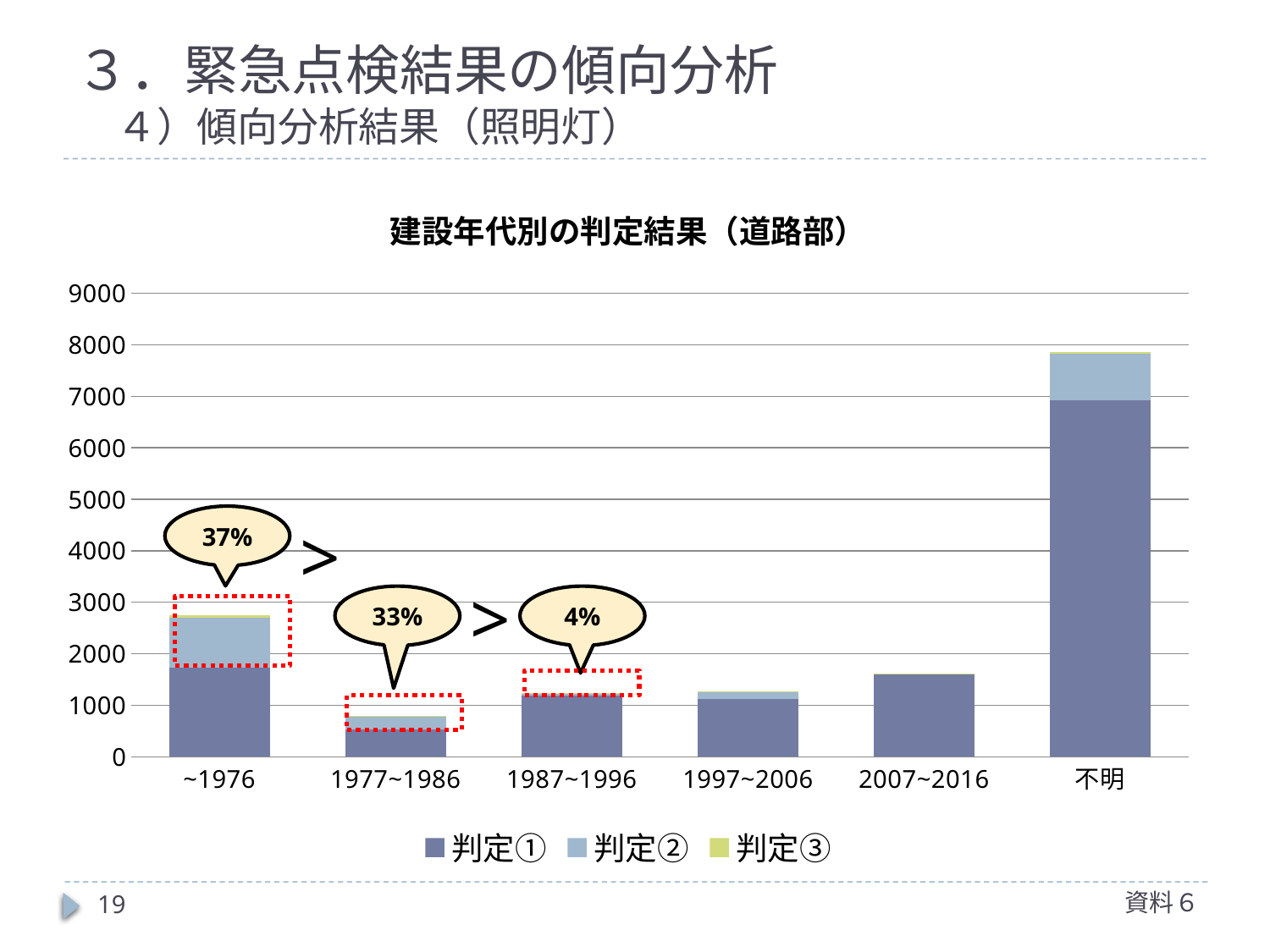
Which category has the highest total bar? 不明 How many construction-period categories are shown on the x axis? 6 What type of chart is shown on the slide? stacked bar chart Is the 判定① value for 不明 greater or less than 6000? greater Is the total for 不明 greater or less than 7000? greater Which category has the lowest total bar? 1977~1986 How many series does the legend list? 3 What percentage is shown in the callout above the ~1976 bar? 37% Which has the larger total bar, 2007~2016 or 1997~2006? 2007~2016 What is the title of the chart? 建設年代別の判定結果（道路部） Is the total for ~1976 greater or less than 3000? less